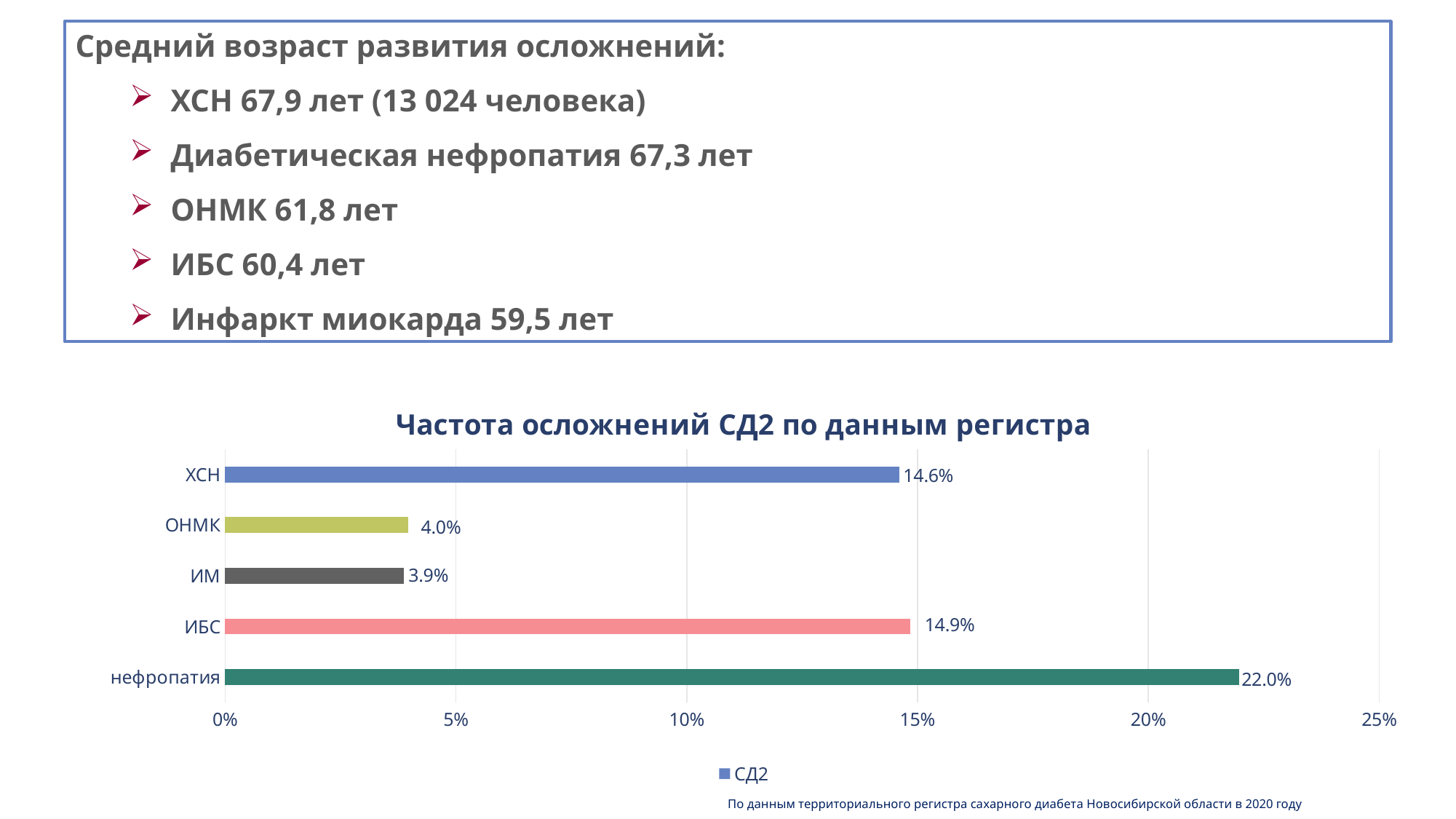
What is the value for ИМ in the chart? 3.9% What is the value for нефропатия in the chart? 22.0% What is the title of the chart? Частота осложнений СД2 по данным регистра What is the difference between the values for нефропатия and ОНМК? 18.0% What is the difference between the values for ИБС and ХСН? 0.3% What is the value for ХСН in the chart? 14.6% Is the value for ИБС greater or less than 10%? greater How many categories are shown in the chart? 5 How many series does the legend list? 1 Which is larger, the value for ОНМК or the value for ИМ? ОНМК What kind of chart is shown on the slide? bar chart Which category has the highest value in the chart? нефропатия